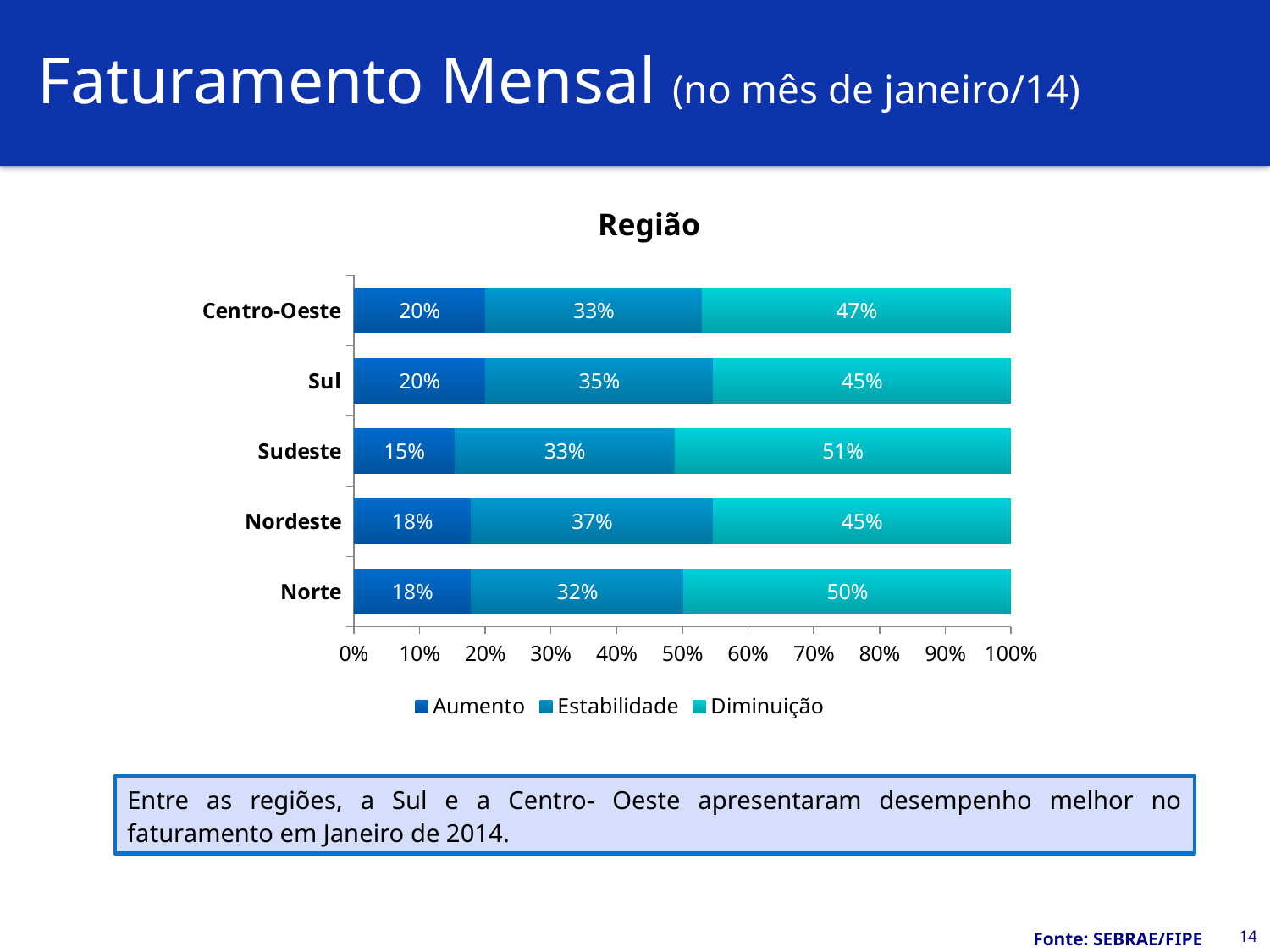
Which is larger, the Estabilidade value for Nordeste or for Norte? Nordeste What is the total of the stacked bar for Centro-Oeste? 100% What is the title of the chart? Região What kind of chart is shown on the slide? Stacked bar chart What is the difference between the Diminuição values for Sudeste and Sul? 6% Which region has the highest Diminuição value? Sudeste What is the Aumento value for Centro-Oeste? 20% What is the Diminuição value for Sudeste? 51% How many series does the legend list? 3 How many regions are shown on the chart? 5 Which region has the lowest Aumento value? Sudeste What is the Estabilidade value for Nordeste? 37%